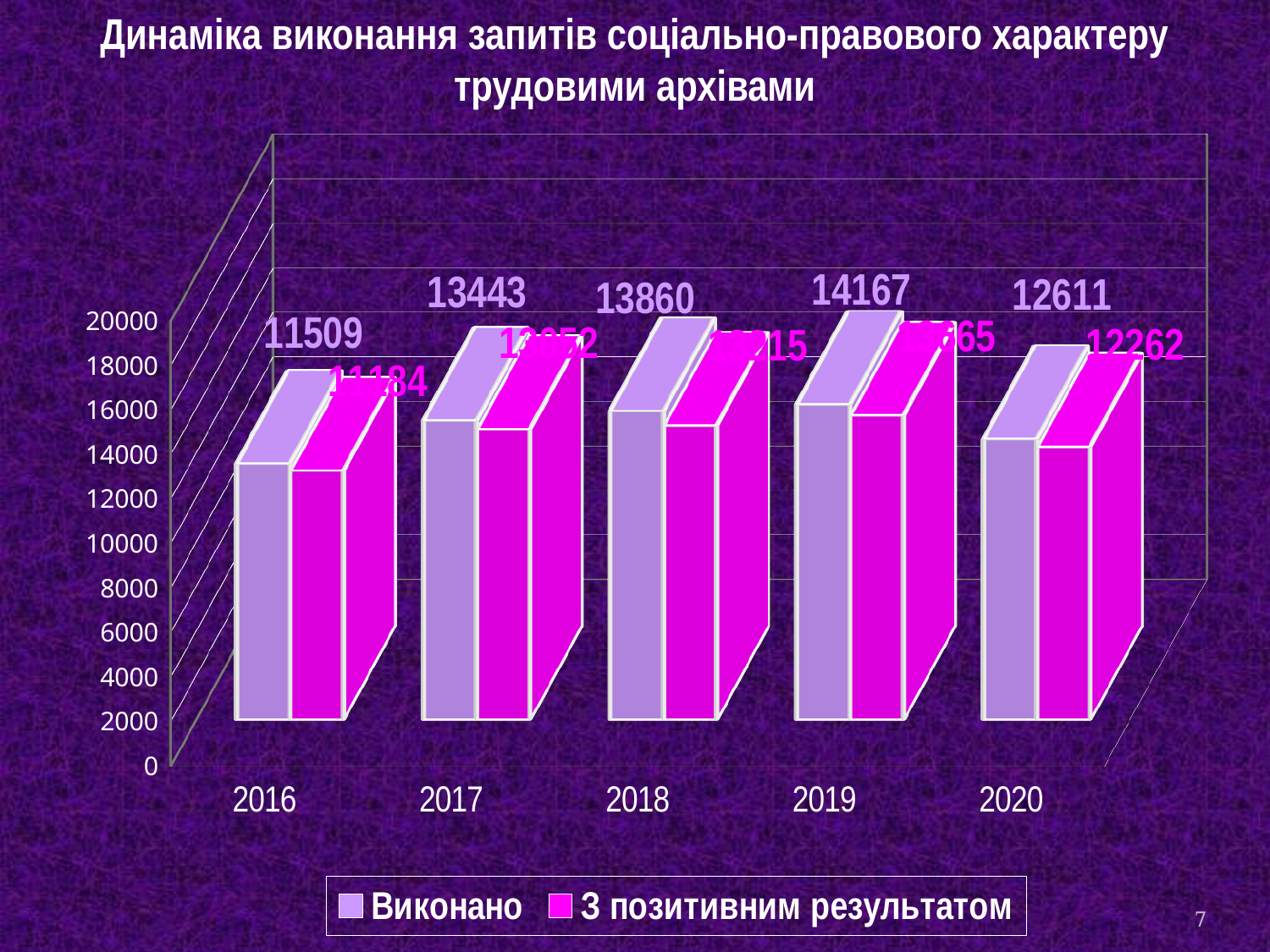
In which year is the "Виконано" value lowest? 2016 How does the "Виконано" value change from 2016 to 2019? It rises How many series does the legend list? 2 Which year has the larger "Виконано" value, 2017 or 2018? 2018 What is the value of the "З позитивним результатом" series for 2020? 12262 What is the value of the "Виконано" series for 2019? 14167 In which year is the "Виконано" value highest? 2019 What kind of chart is shown on the slide? Bar chart What is the value of the "Виконано" series for 2016? 11509 What is the difference between the "Виконано" values for 2019 and 2016? 2658 How many years are shown on the x axis? 5 For 2020, what is the difference between the "Виконано" value and the "З позитивним результатом" value? 349